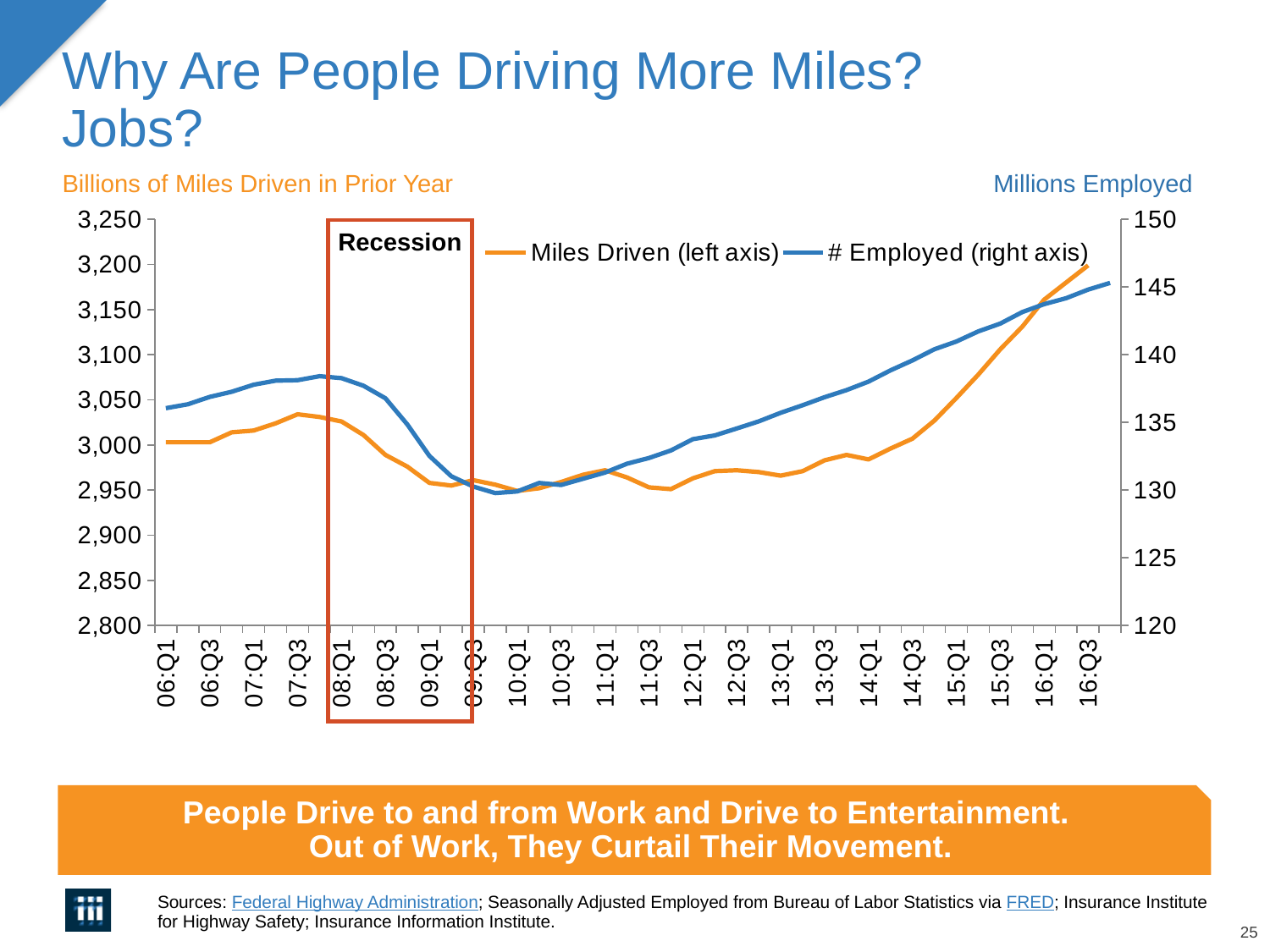
Is the Miles Driven value at 10:Q1 greater or less than 3,000? less Is the Miles Driven value at 16:Q3 greater or less than 3,150? greater Does the Miles Driven line rise or fall from 14:Q1 to 16:Q3? rise Is the # Employed value at 10:Q1 greater or less than 135? less How many quarter labels are shown along the x axis? 22 Does the # Employed line rise or fall from 08:Q1 to 09:Q3? fall What label is shown above the left axis of the chart? Billions of Miles Driven in Prior Year What kind of chart is shown on the slide? line chart Which series is plotted against the right axis? # Employed How many series does the chart's legend list? 2